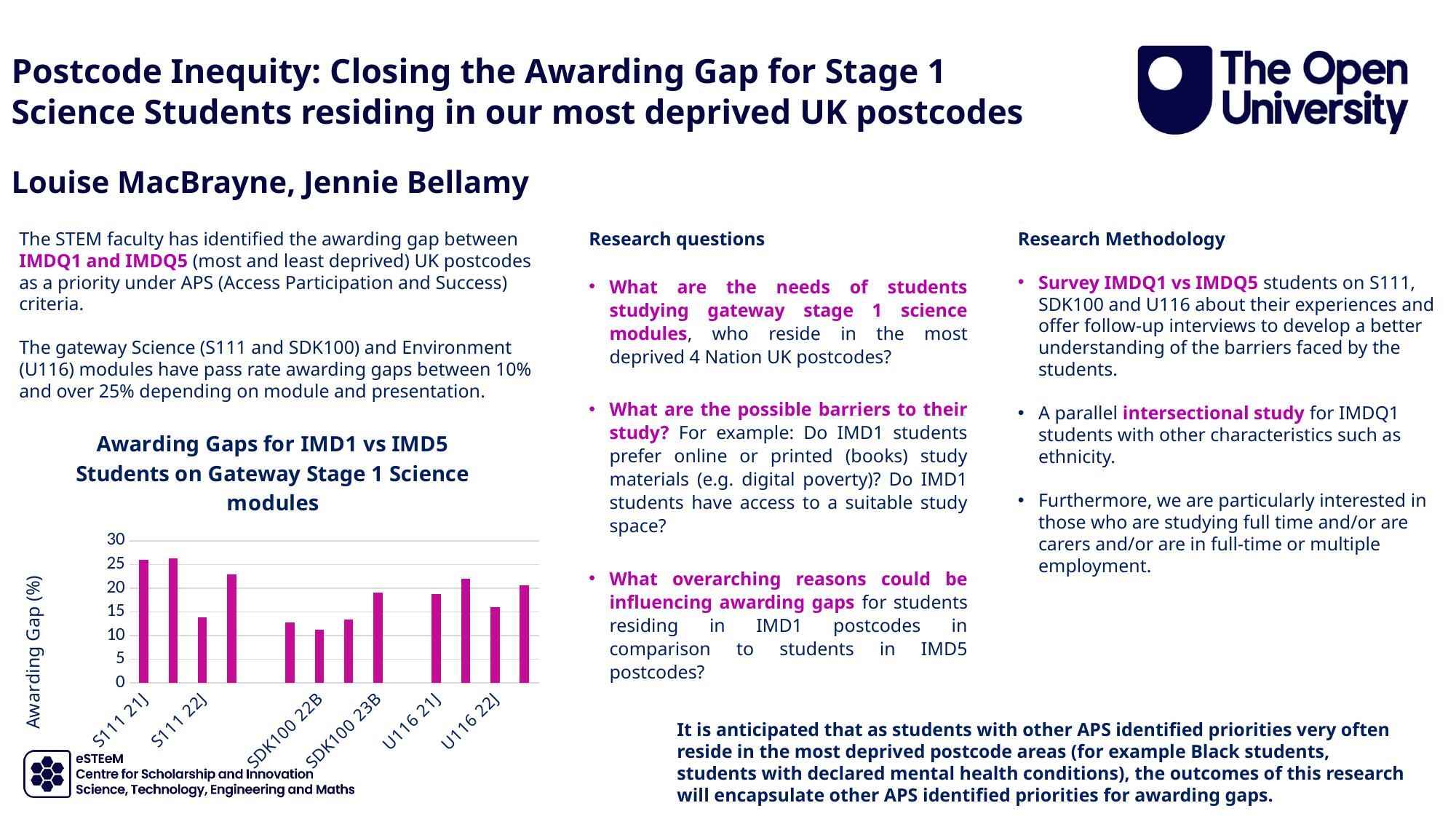
Is the value for S111 21J greater or less than SDK100 22B? greater How many bars are plotted in the chart? 12 What is the highest tick value shown on the vertical axis of the chart? 30 Is the value for SDK100 22B greater or less than 15? less Is the value for S111 21J greater or less than 20? greater Is the value for U116 22J greater or less than 25? less What kind of chart is shown on the slide? Bar chart What is the label on the vertical axis of the chart? Awarding Gap (%) What is the title of the chart? Awarding Gaps for IMD1 vs IMD5 Students on Gateway Stage 1 Science modules